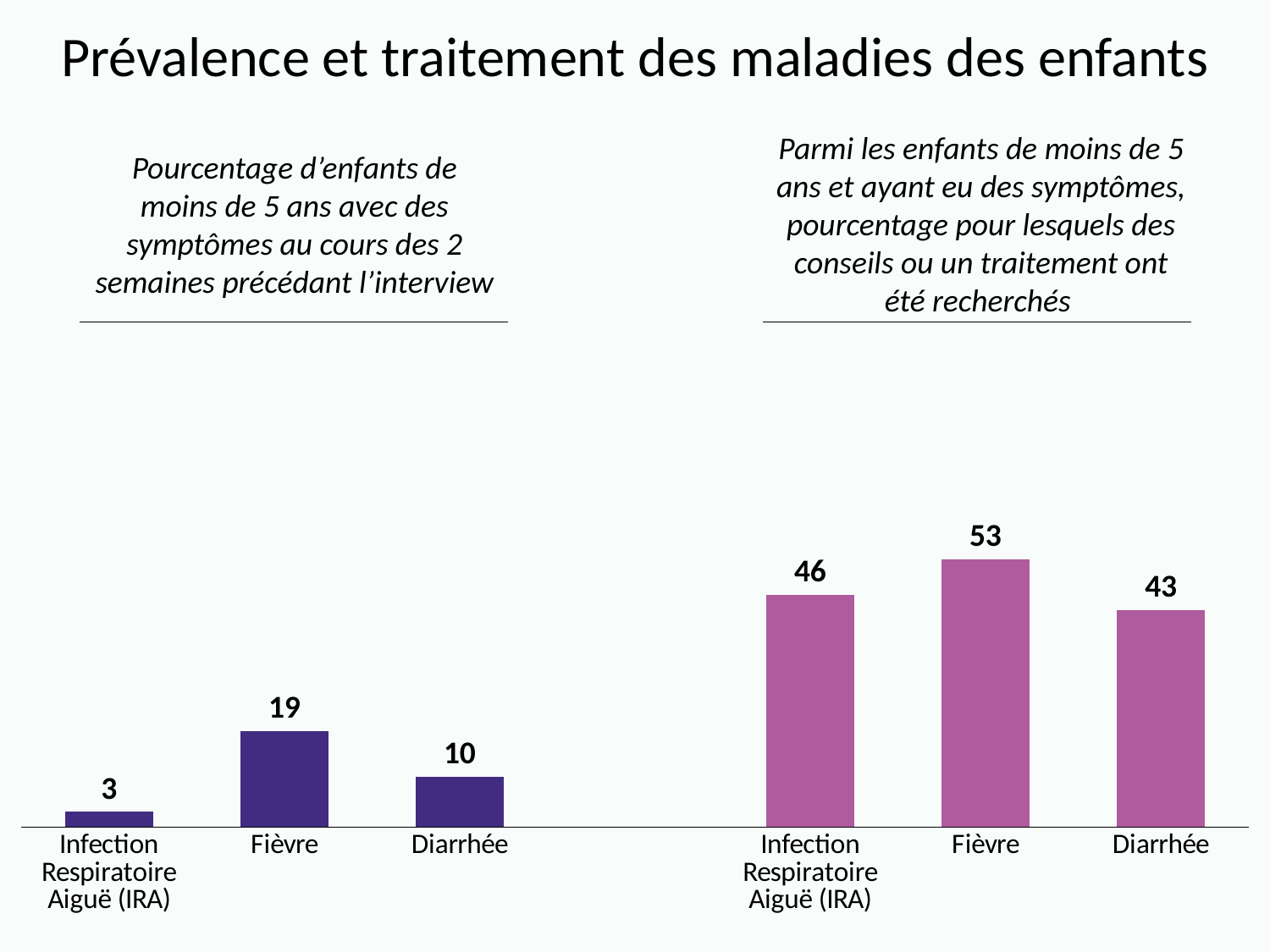
In the right chart, which category has the highest value? Fièvre In the left chart, what is the value for Infection Respiratoire Aiguë (IRA)? 3 In the left chart, which category has the lowest value? Infection Respiratoire Aiguë (IRA) In the left chart (percentage of children under 5 with symptoms in the 2 weeks before the interview), what is the value for Fièvre? 19 In the right chart, which is larger, the value for Infection Respiratoire Aiguë (IRA) or the value for Diarrhée? Infection Respiratoire Aiguë (IRA) How many categories are shown in the left chart? 3 In the left chart, what is the difference between the values for Fièvre and Diarrhée? 9 In the right chart, what is the difference between the values for Fièvre and Infection Respiratoire Aiguë (IRA)? 7 In the right chart (percentage for whom advice or treatment was sought), what is the value for Diarrhée? 43 What is the title of the slide? Prévalence et traitement des maladies des enfants What kind of chart is the right chart? Bar chart In the left chart, what is the value for Diarrhée? 10